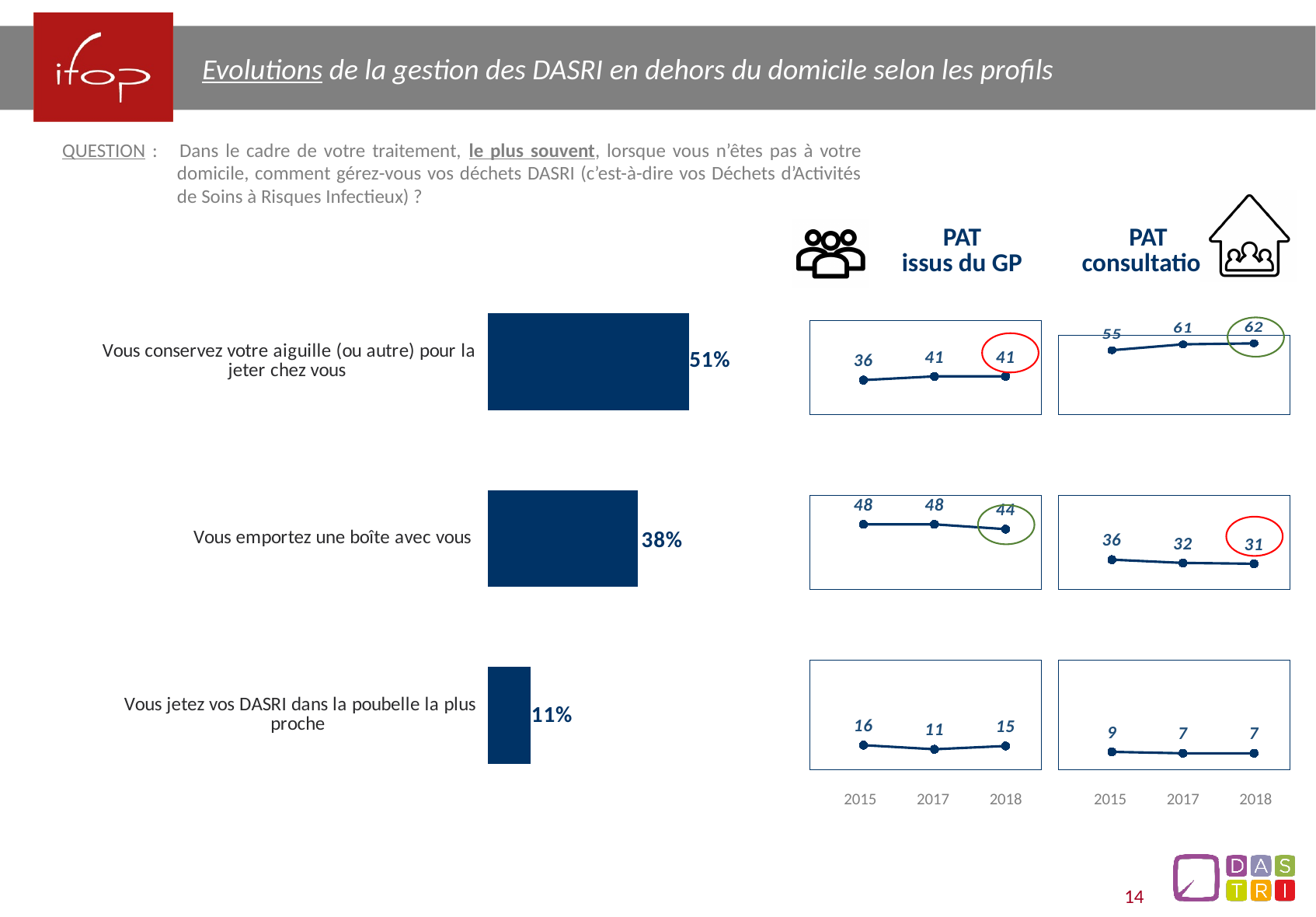
In the main bar chart, what is the value for "Vous conservez votre aiguille (ou autre) pour la jeter chez vous"? 51% Which is larger for 2018 in the "Vous jetez vos DASRI dans la poubelle la plus proche" row: the "PAT issus du GP" value or the "PAT consultation" value? PAT issus du GP In the "PAT issus du GP" line chart for "Vous jetez vos DASRI dans la poubelle la plus proche", which year has the lowest value? 2017 In the "PAT issus du GP" line chart for "Vous conservez votre aiguille (ou autre) pour la jeter chez vous", what is the value for 2015? 36 In the "PAT consultation" line chart for "Vous conservez votre aiguille (ou autre) pour la jeter chez vous", what is the value for 2018? 62 What kind of chart is the main chart on the left of the slide? Bar chart In the "PAT issus du GP" line chart for "Vous emportez une boîte avec vous", what is the difference between the 2015 and 2018 values? 4 In the main bar chart, which category has the lowest value? Vous jetez vos DASRI dans la poubelle la plus proche How many categories does the main bar chart show? 3 In the main bar chart, what is the difference between "Vous conservez votre aiguille (ou autre) pour la jeter chez vous" and "Vous emportez une boîte avec vous"? 13% In the main bar chart, what is the value for "Vous jetez vos DASRI dans la poubelle la plus proche"? 11% In the "PAT consultation" line chart for "Vous emportez une boîte avec vous", do the values rise or fall from 2015 to 2018? Fall